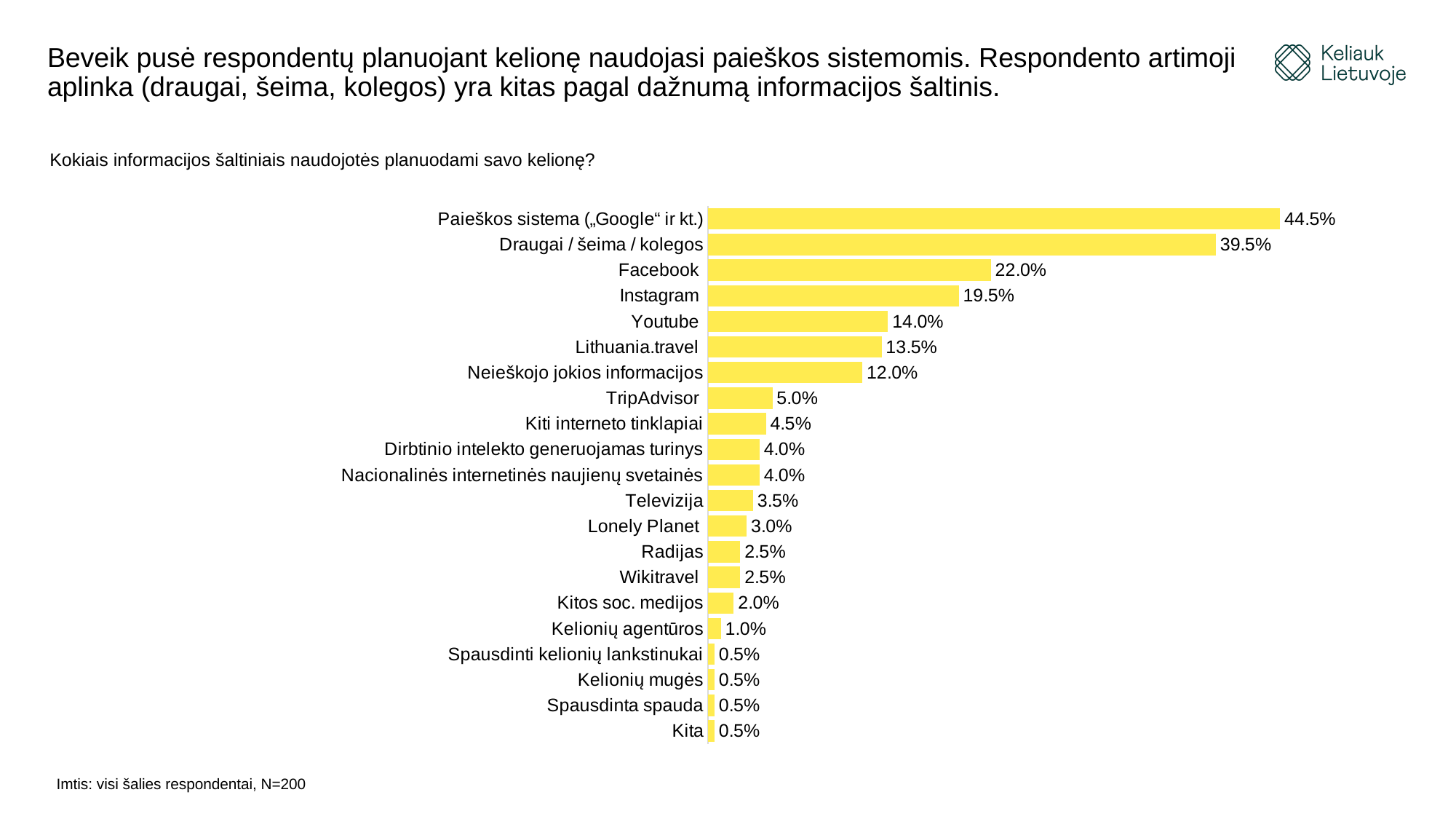
What is the value shown for Lithuania.travel? 13.5% What is the difference between the values for Facebook and Instagram? 2.5% Which has a larger value, Youtube or TripAdvisor? Youtube How many information source categories are shown in the chart? 21 What kind of chart is shown on the slide? Bar chart What percentage is shown for "Neieškojo jokios informacijos"? 12.0% What is the difference between the values for Paieškos sistema („Google“ ir kt.) and Draugai / šeima / kolegos? 5.0% What percentage of respondents used Facebook as an information source? 22.0% Which has a larger value, Televizija or Lonely Planet? Televizija What colour are the bars in the chart? Yellow What is the value for Kelionių agentūros? 1.0% Which information source has the highest value in the chart? Paieškos sistema („Google“ ir kt.)